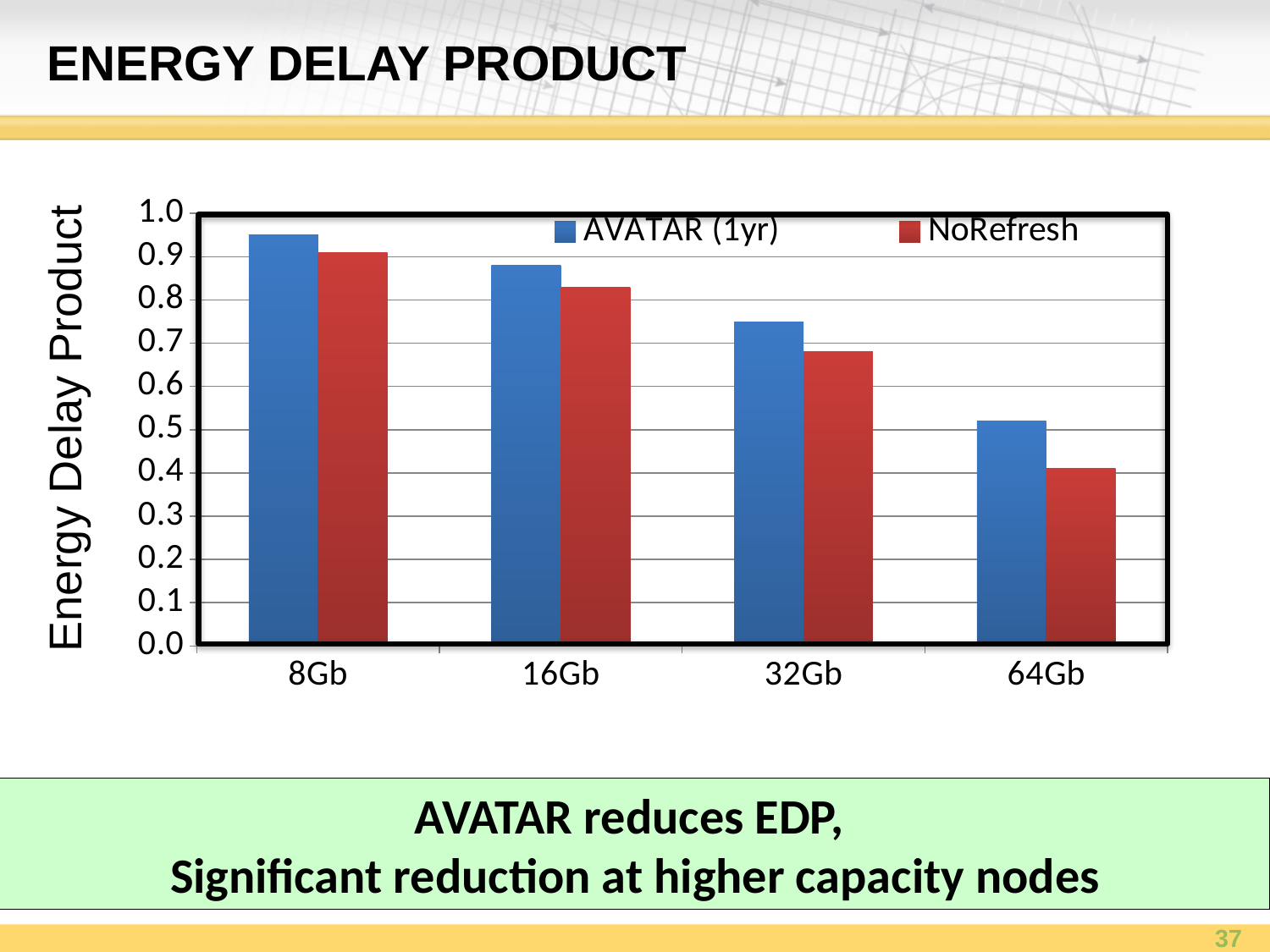
Which capacity has the lowest NoRefresh value? 64Gb Is the NoRefresh value for 64Gb greater or less than 0.5? less Is the AVATAR (1yr) value for 8Gb greater or less than 0.9? greater Do the NoRefresh values rise or fall as capacity increases from 8Gb to 64Gb? fall Is the AVATAR (1yr) value for 16Gb greater or less than 0.8? greater What is the label on the y axis of the chart? Energy Delay Product Which capacity has the highest AVATAR (1yr) value? 8Gb How many capacity categories are shown on the x axis? 4 What kind of chart is shown on the slide? bar chart How many series does the legend list? 2 At 64Gb, which series has the larger value, AVATAR (1yr) or NoRefresh? AVATAR (1yr)